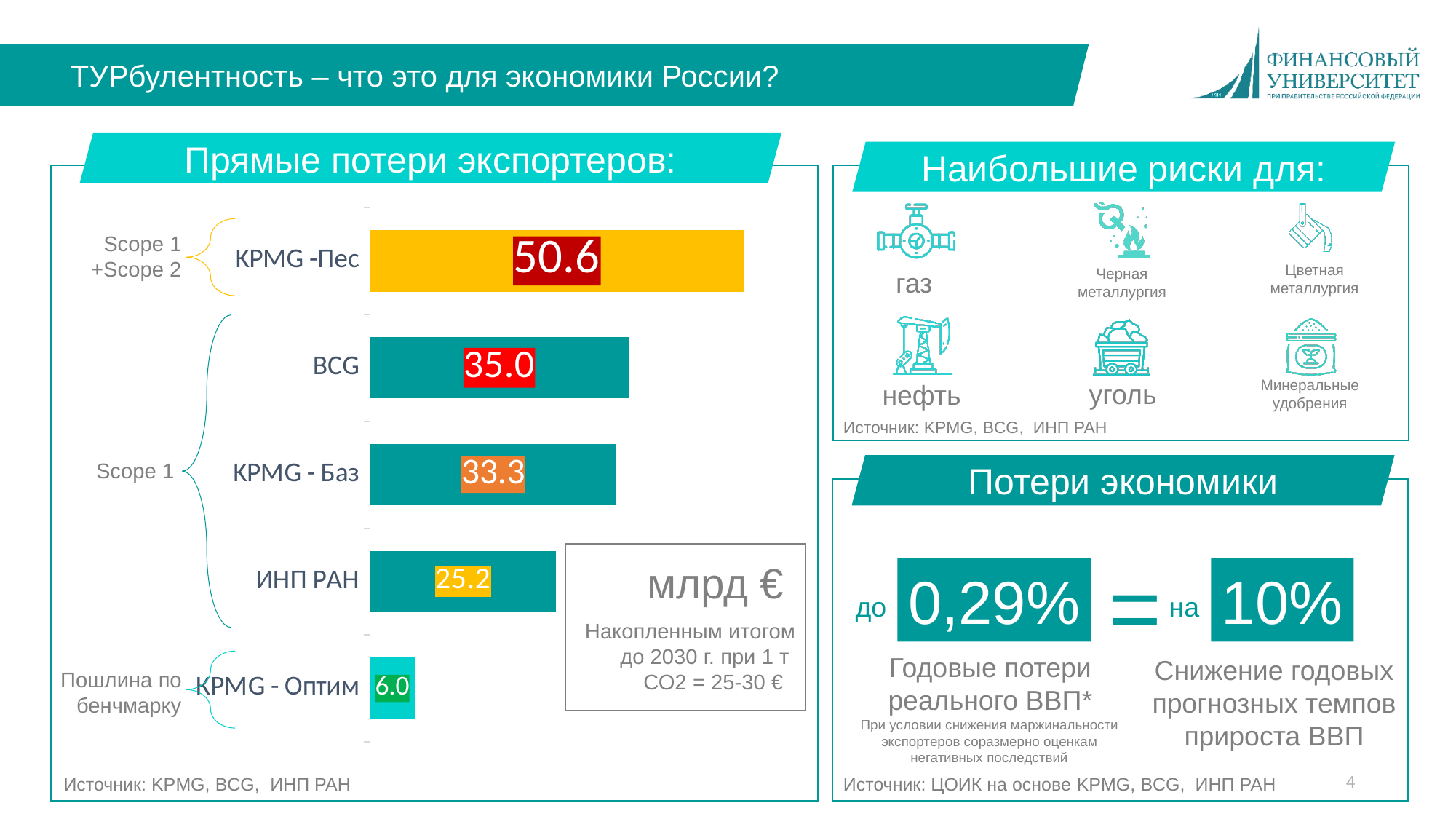
What type of chart is 'Прямые потери экспортеров'? Bar chart What is the value for ИНП РАН in the chart 'Прямые потери экспортеров'? 25.2 Which category has the lowest value in the chart 'Прямые потери экспортеров'? KPMG - Оптим What is the difference between the values for KPMG -Пес and BCG in the chart 'Прямые потери экспортеров'? 15.6 Which category has the highest value in the chart 'Прямые потери экспортеров'? KPMG -Пес In what units are the values in the chart 'Прямые потери экспортеров' expressed? млрд € How many categories (bars) are shown in the chart 'Прямые потери экспортеров'? 5 What is the value for KPMG - Баз in the chart 'Прямые потери экспортеров'? 33.3 What is the value for KPMG -Пес in the chart 'Прямые потери экспортеров'? 50.6 Which is larger in the chart 'Прямые потери экспортеров': the value for ИНП РАН or the value for KPMG - Баз? KPMG - Баз What is the value for BCG in the chart 'Прямые потери экспортеров'? 35.0 What is the value for KPMG - Оптим in the chart 'Прямые потери экспортеров'? 6.0